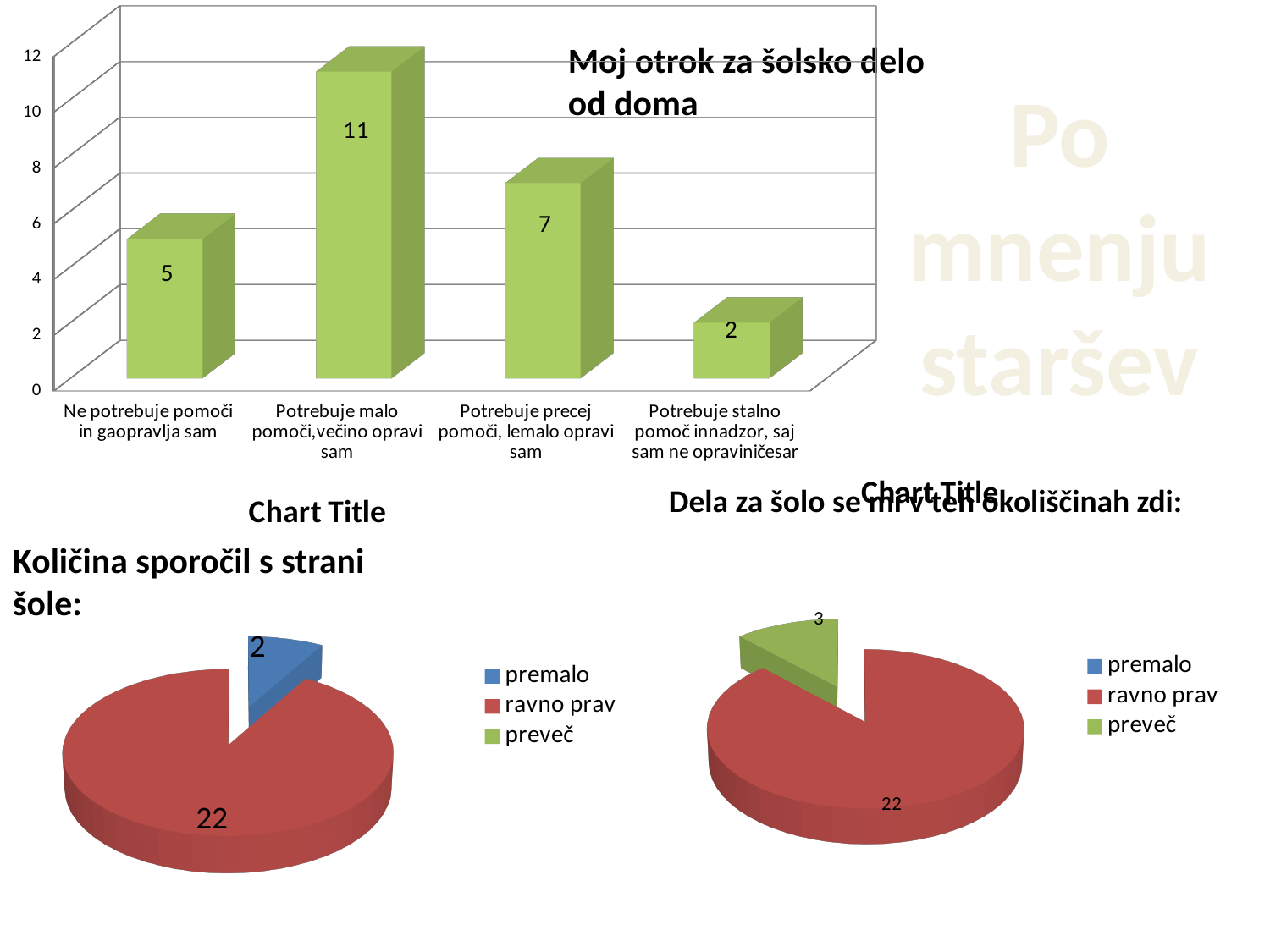
In the pie chart 'Količina sporočil s strani šole:', what is the value for 'ravno prav'? 22 In the pie chart 'Količina sporočil s strani šole:', what is the value for 'premalo'? 2 In the bar chart 'Moj otrok za šolsko delo od doma', what is the value for 'Potrebuje stalno pomoč in nadzor, saj sam ne opravi ničesar'? 2 What kind of chart is the chart titled 'Moj otrok za šolsko delo od doma'? bar chart In the bar chart 'Moj otrok za šolsko delo od doma', which is larger: the value for 'Ne potrebuje pomoči in ga opravlja sam' or for 'Potrebuje precej pomoči, le malo opravi sam'? Potrebuje precej pomoči, le malo opravi sam In the pie chart 'Dela za šolo se mi v teh okoliščinah zdi:', what is the value for 'preveč'? 3 In the bar chart 'Moj otrok za šolsko delo od doma', what is the difference between the values for 'Potrebuje malo pomoči, večino opravi sam' and 'Potrebuje precej pomoči, le malo opravi sam'? 4 How many entries does the legend of the pie chart 'Dela za šolo se mi v teh okoliščinah zdi:' list? 3 In the bar chart 'Moj otrok za šolsko delo od doma', which category has the highest value? Potrebuje malo pomoči, večino opravi sam How many categories are shown in the bar chart 'Moj otrok za šolsko delo od doma'? 4 In the bar chart 'Moj otrok za šolsko delo od doma', which category has the lowest value? Potrebuje stalno pomoč in nadzor, saj sam ne opravi ničesar In the bar chart 'Moj otrok za šolsko delo od doma', what is the value for 'Potrebuje malo pomoči, večino opravi sam'? 11